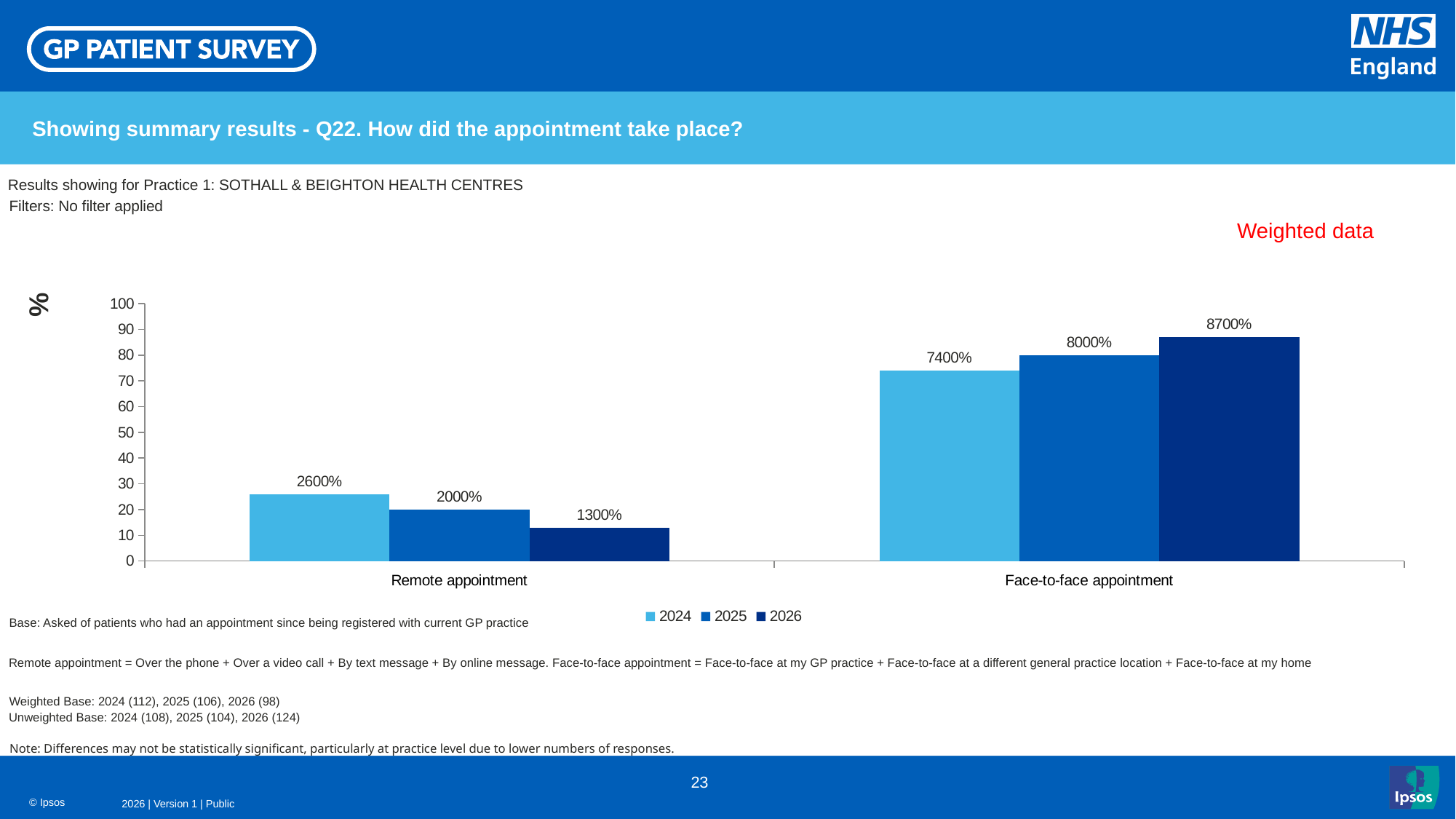
How many series does the legend list? 3 Which is larger: the 2025 value for Remote appointment or the 2025 value for Face-to-face appointment? Face-to-face appointment Do the Remote appointment values rise or fall from 2024 to 2026? Fall What is the difference between the 2024 and 2025 data labels for Remote appointment? 600% Which year has the highest value in the Face-to-face appointment category? 2026 What is the data label for 2025 in the Remote appointment category? 2000% Which year has the lowest value in the Remote appointment category? 2026 What is the data label for 2026 in the Face-to-face appointment category? 8700% What is the data label for 2024 in the Remote appointment category? 2600% What is the data label for 2024 in the Face-to-face appointment category? 7400% What kind of chart is shown on the slide? Bar chart How many categories are shown on the x axis? 2